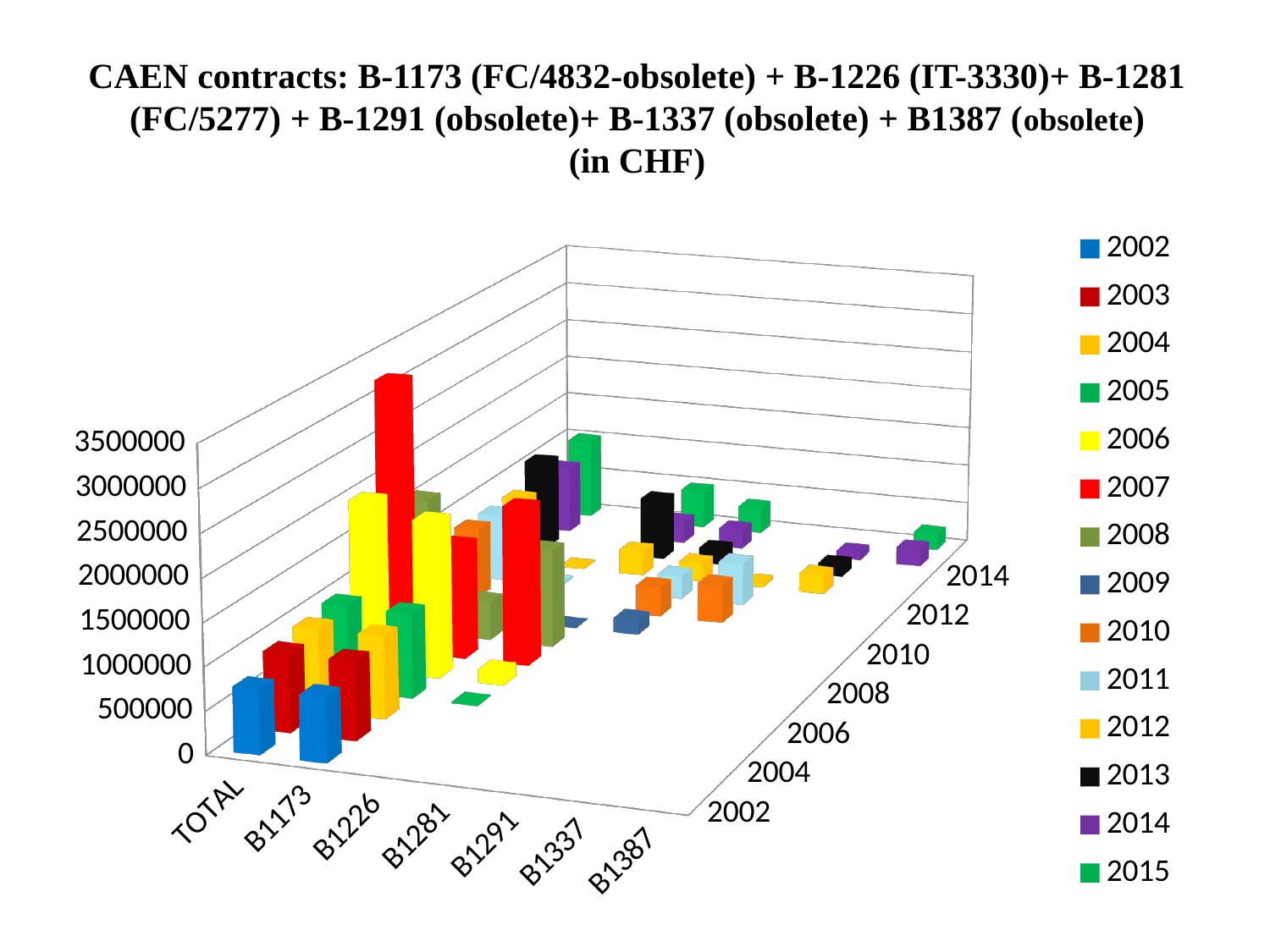
What colour represents the year 2007 in the legend? red How many contract categories are shown along the x axis? 7 How many series (years) does the legend list? 14 In what currency are the values in the chart expressed, according to the title? CHF For the TOTAL category, which year has the tallest bar? 2007 What kind of chart is shown on the slide? bar chart For the TOTAL category, which bar is taller, 2007 or 2002? 2007